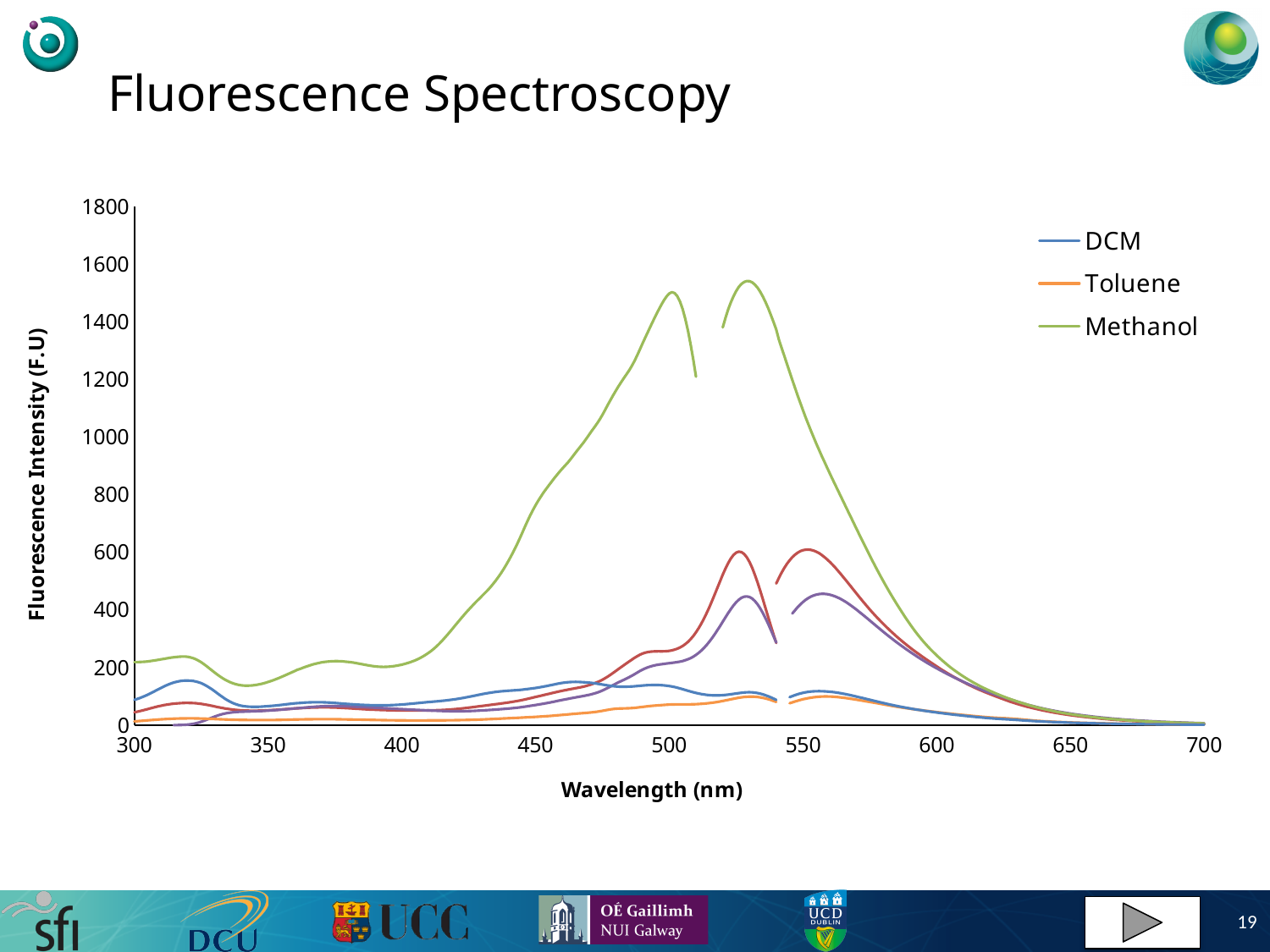
Is the value for DCM at 700 nm greater or less than 200? less Which legend series reaches the highest fluorescence intensity? Methanol What is the title of the x axis? Wavelength (nm) Is the value for Methanol at 400 nm greater or less than 400? less What is the title of the y axis? Fluorescence Intensity (F.U) Is the value for Toluene at 500 nm greater or less than 200? less At 550 nm, which series has the larger value, Methanol or DCM? Methanol How many series does the legend list? 3 Does the Methanol series rise or fall between 550 nm and 700 nm? fall What kind of chart is shown on the slide? line chart